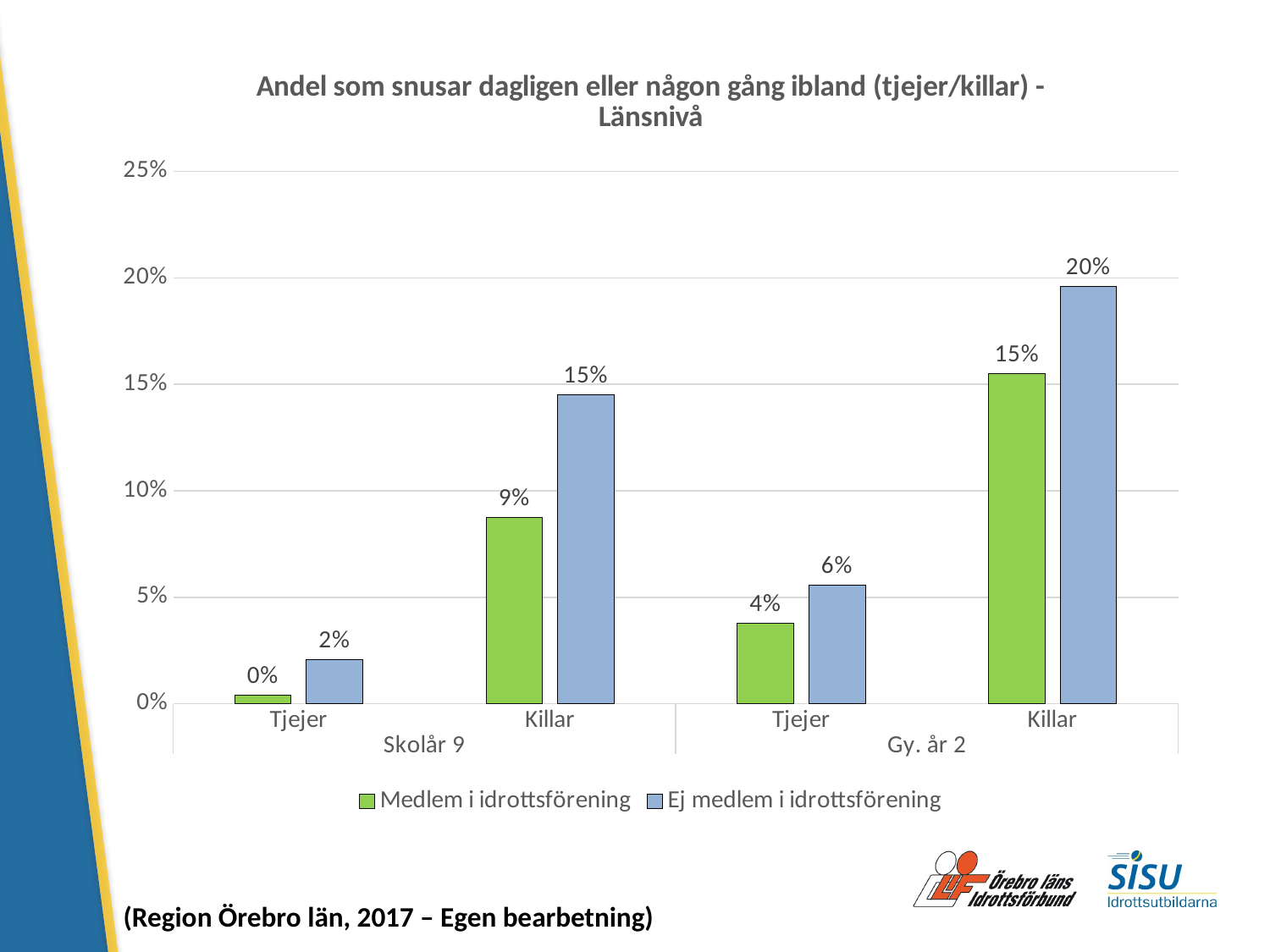
What is the title of the chart? Andel som snusar dagligen eller någon gång ibland (tjejer/killar) - Länsnivå What is the difference between the Ej medlem i idrottsförening and Medlem i idrottsförening values for Killar in Skolår 9? 6% What is the difference between the Ej medlem i idrottsförening and Medlem i idrottsförening values for Killar in Gy. år 2? 5% What is the value for Killar in Skolår 9 for the series Ej medlem i idrottsförening? 15% Which group has the highest value for the series Ej medlem i idrottsförening? Killar, Gy. år 2 Which is larger: the Medlem i idrottsförening value for Killar in Gy. år 2 or the Ej medlem i idrottsförening value for Killar in Skolår 9? They are equal (15%) What kind of chart is shown on the slide? Bar chart Which is larger: the Ej medlem i idrottsförening value for Tjejer in Gy. år 2 or the Medlem i idrottsförening value for Killar in Skolår 9? Medlem i idrottsförening value for Killar in Skolår 9 (9%) What is the value for Tjejer in Skolår 9 for the series Ej medlem i idrottsförening? 2% Which group has the lowest value for the series Medlem i idrottsförening? Tjejer, Skolår 9 How many series does the legend list? 2 What is the value for Tjejer in Gy. år 2 for the series Medlem i idrottsförening? 4%